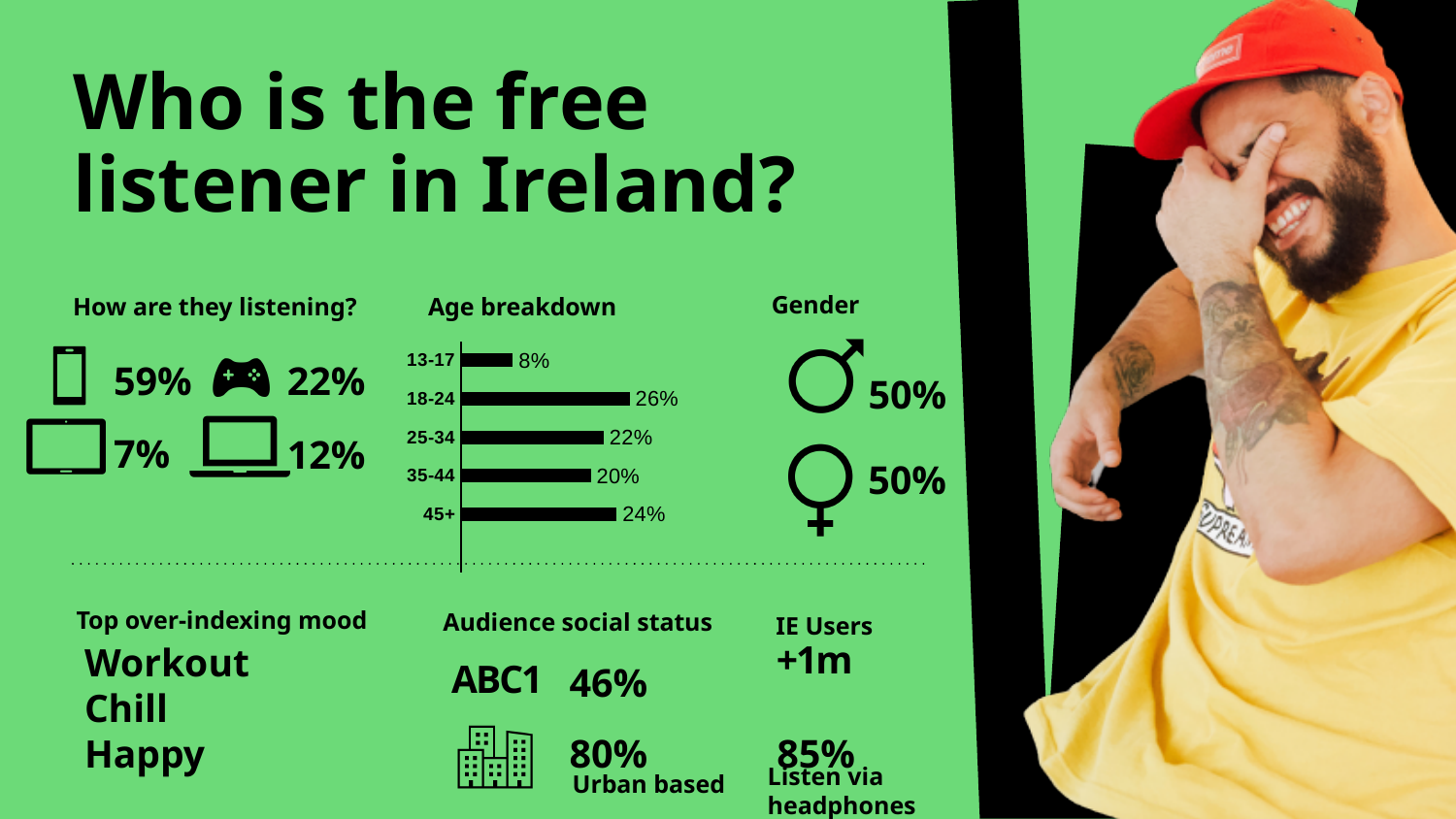
In the Age breakdown chart, what is the value for the 45+ age group? 24% What type of chart is the Age breakdown chart? Bar chart In the Age breakdown chart, what is the value for the 18-24 age group? 26% In the Age breakdown chart, which is larger: the value for 25-34 or the value for 35-44? 25-34 What is the title of the bar chart on the slide? Age breakdown In the Age breakdown chart, what is the value for the 13-17 age group? 8% How many age groups are shown in the Age breakdown chart? 5 In the Age breakdown chart, what is the value for the 35-44 age group? 20% In the Age breakdown chart, what is the difference between the 18-24 and 13-17 values? 18% In the Age breakdown chart, which age group has the lowest value? 13-17 In the Age breakdown chart, which age group has the highest value? 18-24 In the Age breakdown chart, what is the difference between the 45+ and 25-34 values? 2%